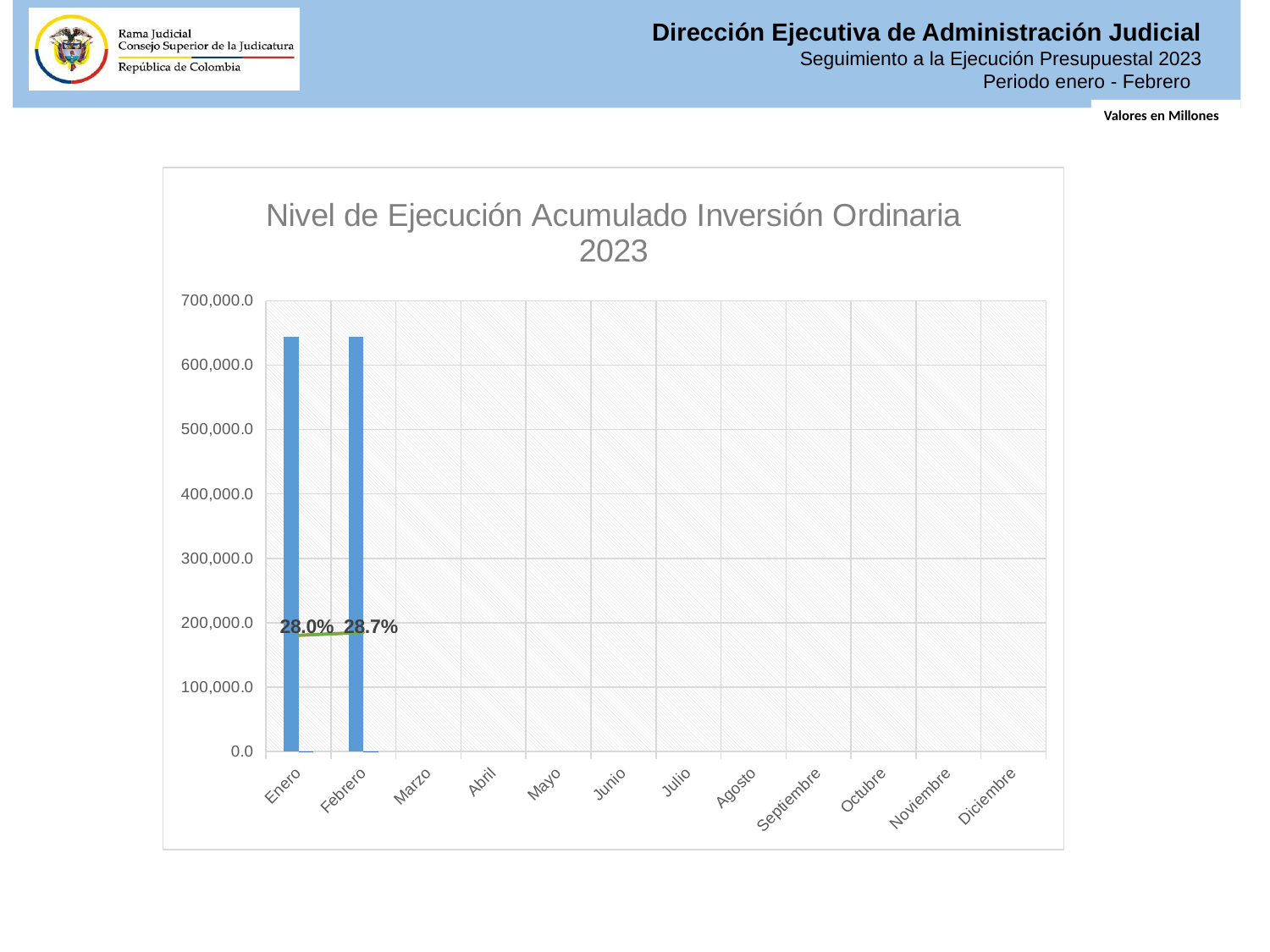
How many month categories are shown on the x axis? 12 Is the bar value for Enero greater or less than 600,000.0? greater What is the difference between the percentage labelled for Febrero and the percentage labelled for Enero? 0.7% Is the bar value for Febrero greater or less than 700,000.0? less What percentage is labelled for Enero? 28.0% What percentage is labelled for Febrero? 28.7% What is the highest value shown on the y axis? 700,000.0 Does the labelled percentage rise or fall from Enero to Febrero? rise What kind of chart is used to show the monthly values? bar chart What is the title of the chart? Nivel de Ejecución Acumulado Inversión Ordinaria 2023 Which month has the higher labelled percentage, Enero or Febrero? Febrero How many months have a visible bar plotted? 2